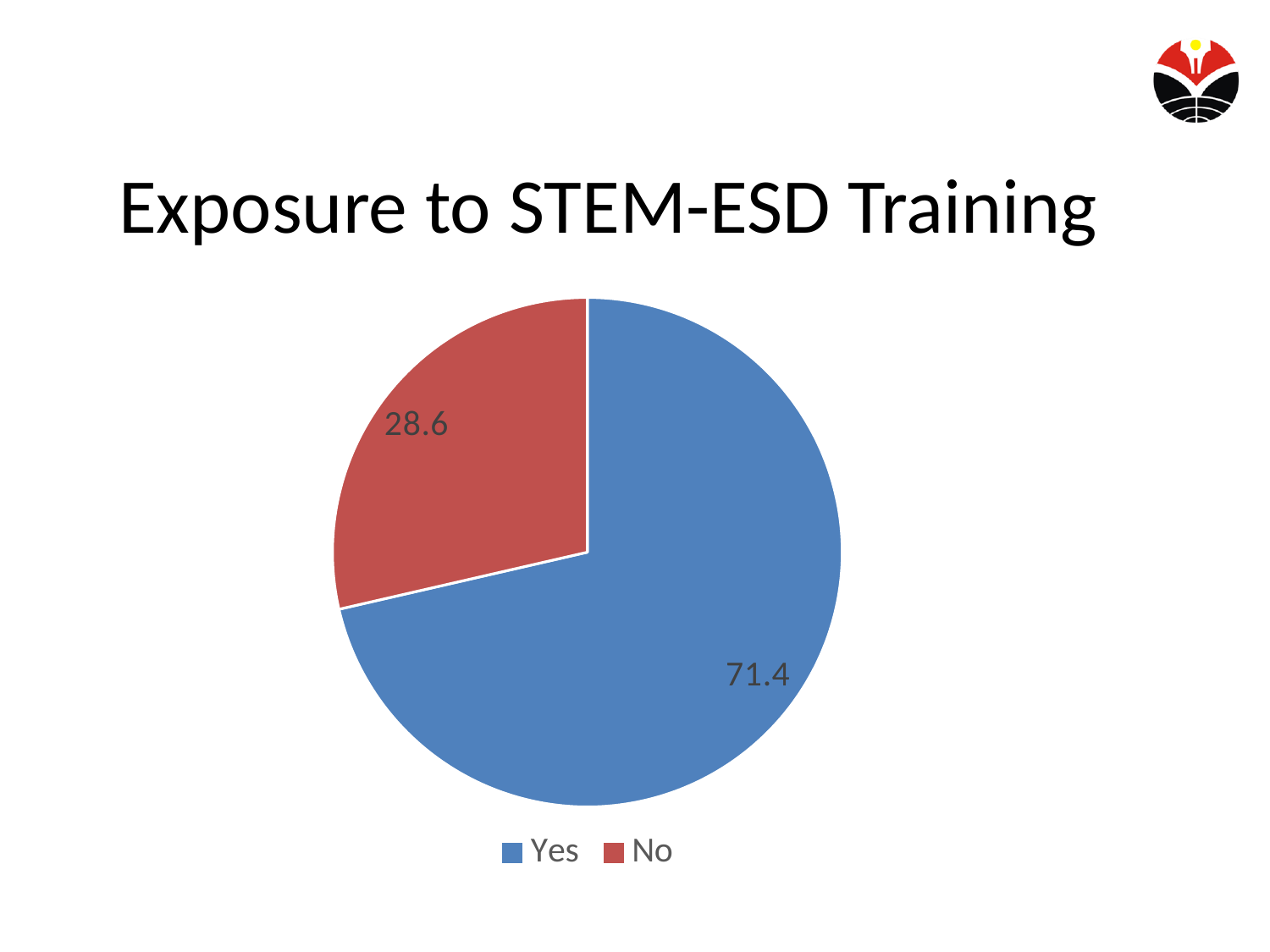
What colour is the Yes slice? blue Which category has the smallest slice? No How many entries does the legend list? 2 How many slices does the pie chart have? 2 What is the difference between the values for Yes and No? 42.8 Which category has the largest slice? Yes What is the title of the slide? Exposure to STEM-ESD Training What is the value for Yes? 71.4 Which is larger, the value for Yes or the value for No? Yes What is the value for No? 28.6 What kind of chart is shown on the slide? pie chart